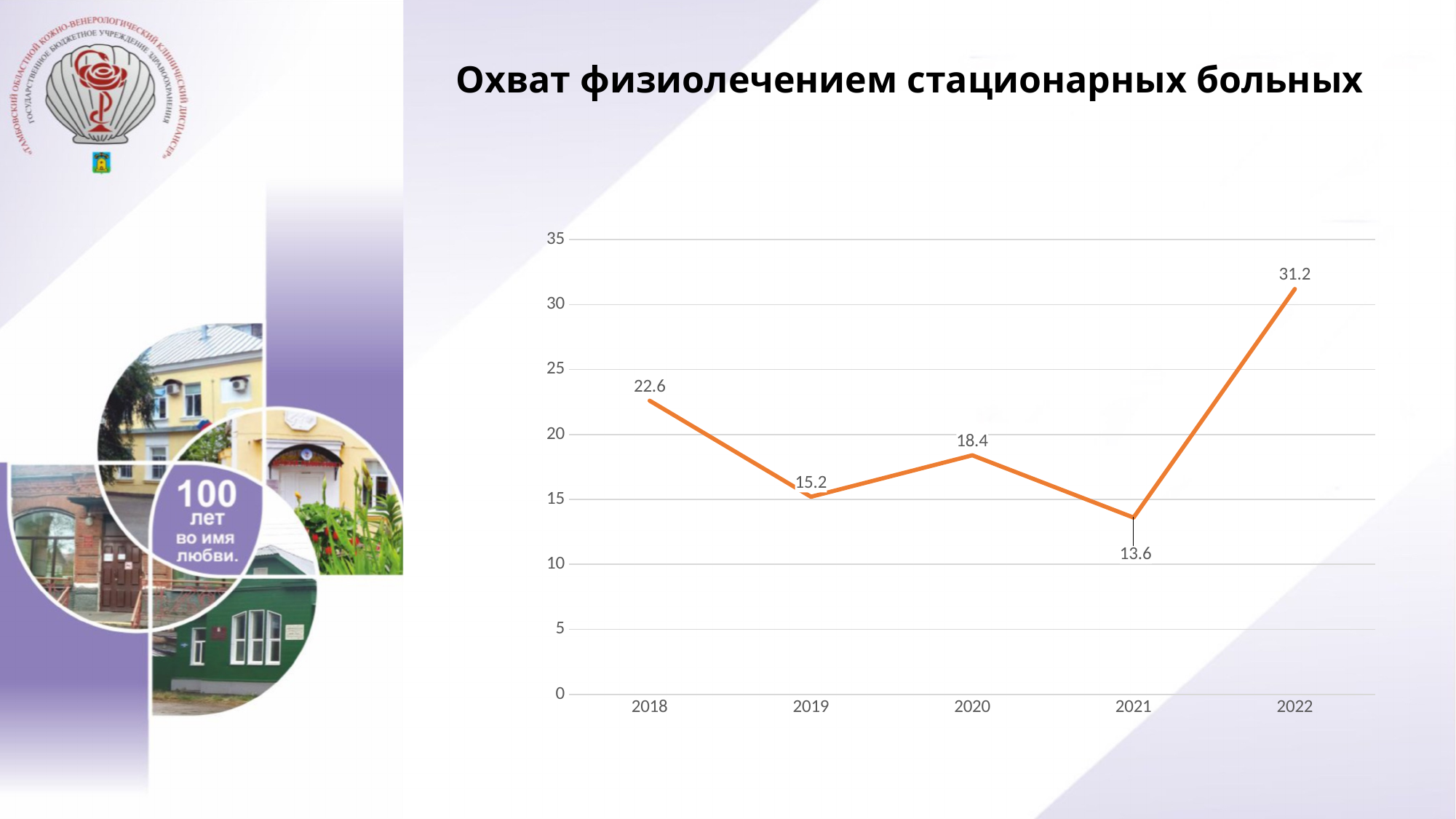
What kind of chart is shown on the slide? line chart Which is larger, the value for 2020 or the value for 2019? 2020 Which year has the lowest value? 2021 What is the difference between the values for 2022 and 2021? 17.6 How many years are plotted on the chart? 5 What is the value for 2022? 31.2 What is the value for 2021? 13.6 Which year has the highest value? 2022 What is the value for 2018? 22.6 What is the title of the chart? Охват физиолечением стационарных больных What is the difference between the values for 2018 and 2019? 7.4 Is the value for 2022 greater or less than 30? greater